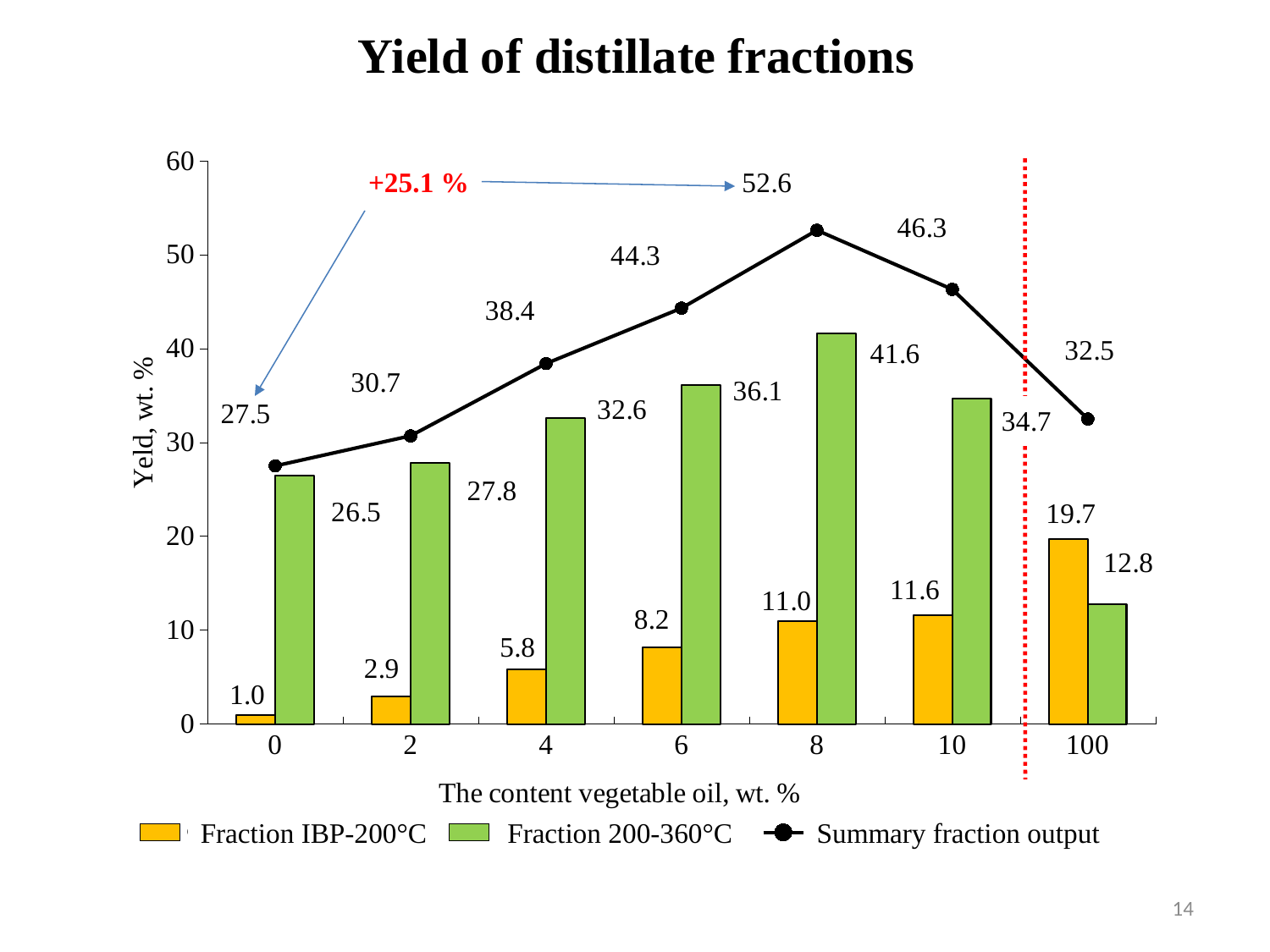
What is the difference between the Summary fraction output at 8 wt. % and at 0 wt. %? 25.1 What is the Summary fraction output at a vegetable oil content of 4 wt. %? 38.4 Does Fraction IBP-200°C rise or fall as the vegetable oil content increases from 0 to 100 wt. %? Rises What is the value of Fraction 200-360°C at a vegetable oil content of 6 wt. %? 36.1 What is the value of Fraction IBP-200°C at a vegetable oil content of 8 wt. %? 11.0 How many series does the legend list? 3 What kind of chart is this? Combined bar and line chart How many vegetable oil content categories are shown on the x axis? 7 At a vegetable oil content of 100 wt. %, which is larger: Fraction IBP-200°C or Fraction 200-360°C? Fraction IBP-200°C At which vegetable oil content is the Summary fraction output highest? 8 At which vegetable oil content is Fraction IBP-200°C lowest? 0 What percentage increase is highlighted in red on the chart? +25.1 %